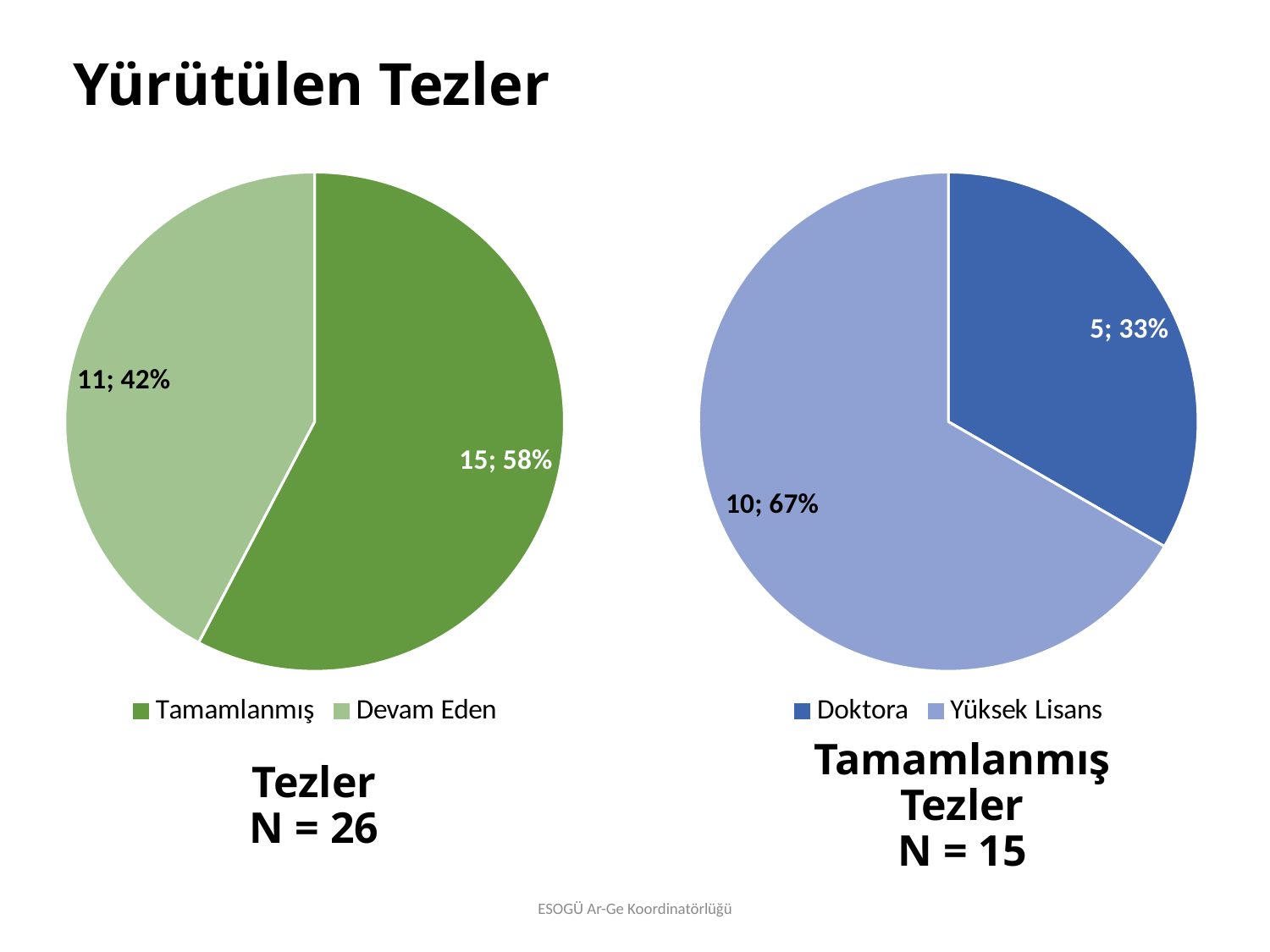
In the left pie chart (Tezler, N = 26), how many theses are Tamamlanmış? 15 In the right pie chart (Tamamlanmış Tezler, N = 15), which is larger, Doktora or Yüksek Lisans? Yüksek Lisans In the left pie chart (Tezler, N = 26), which category is the largest? Tamamlanmış In the right pie chart (Tamamlanmış Tezler, N = 15), which category is the smallest? Doktora In the left pie chart (Tezler, N = 26), how many slices are there? 2 In the left pie chart (Tezler, N = 26), what percentage share does Devam Eden have? 42% What type of chart is the left chart (Tezler, N = 26)? Pie chart In the right pie chart (Tamamlanmış Tezler, N = 15), what is the difference between the Yüksek Lisans and Doktora counts? 5 In the right pie chart (Tamamlanmış Tezler, N = 15), what percentage share does Yüksek Lisans have? 67% What are the legend entries of the right pie chart (Tamamlanmış Tezler, N = 15)? Doktora, Yüksek Lisans In the right pie chart (Tamamlanmış Tezler, N = 15), how many theses are Doktora? 5 In the left pie chart (Tezler, N = 26), what is the difference between the Tamamlanmış and Devam Eden counts? 4